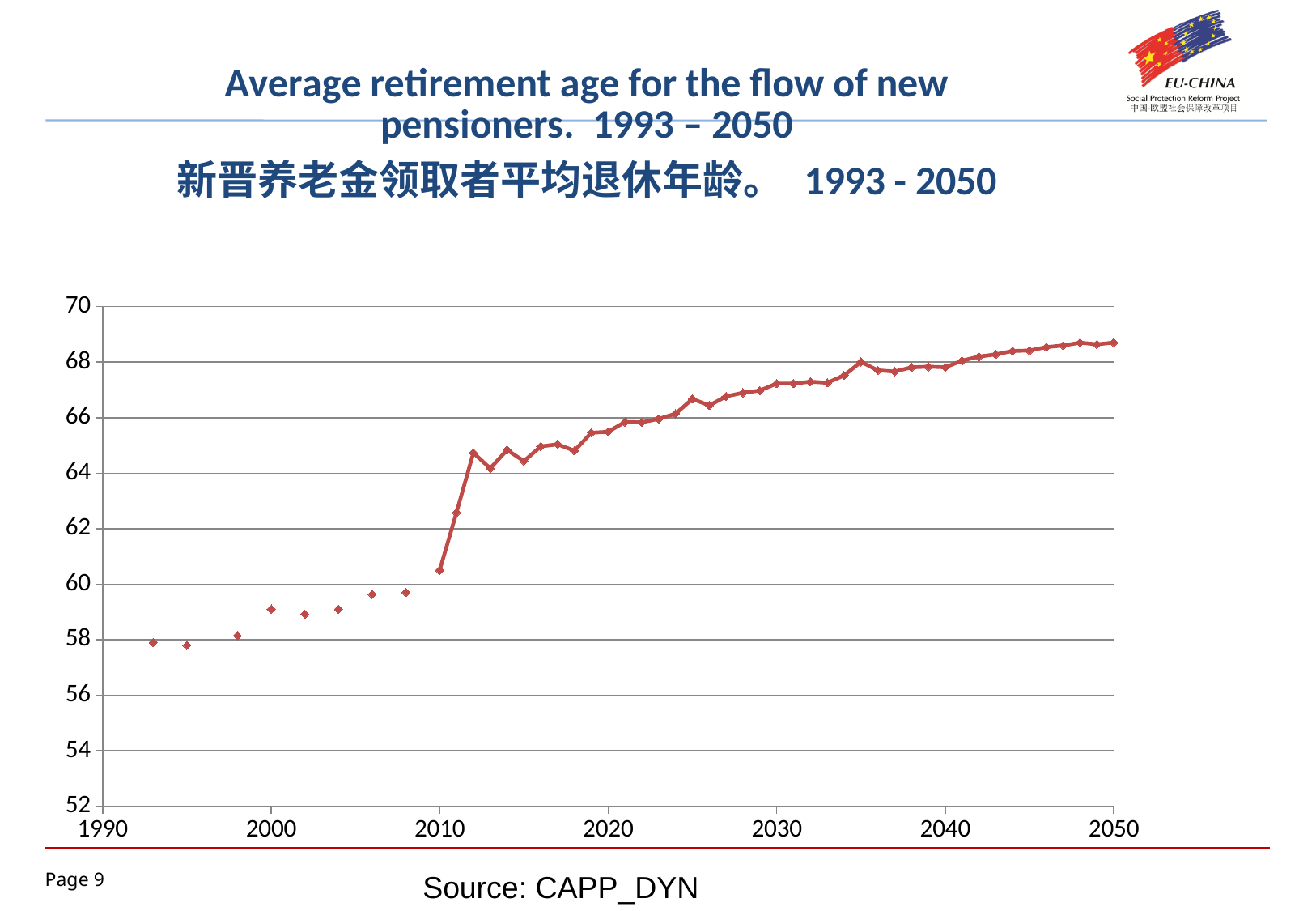
What kind of chart is shown on the slide? line chart Is the value for 2000 greater or less than 60? less Does the average retirement age generally rise or fall from 1993 to 2050? rise Which year has the larger value, 2000 or 2040? 2040 Is the value for 2020 greater or less than 64? greater What source is cited below the chart? CAPP_DYN Is the value for 2030 greater or less than 66? greater Which year has the larger value, 2010 or 2012? 2012 What is the English title of the chart? Average retirement age for the flow of new pensioners. 1993 – 2050